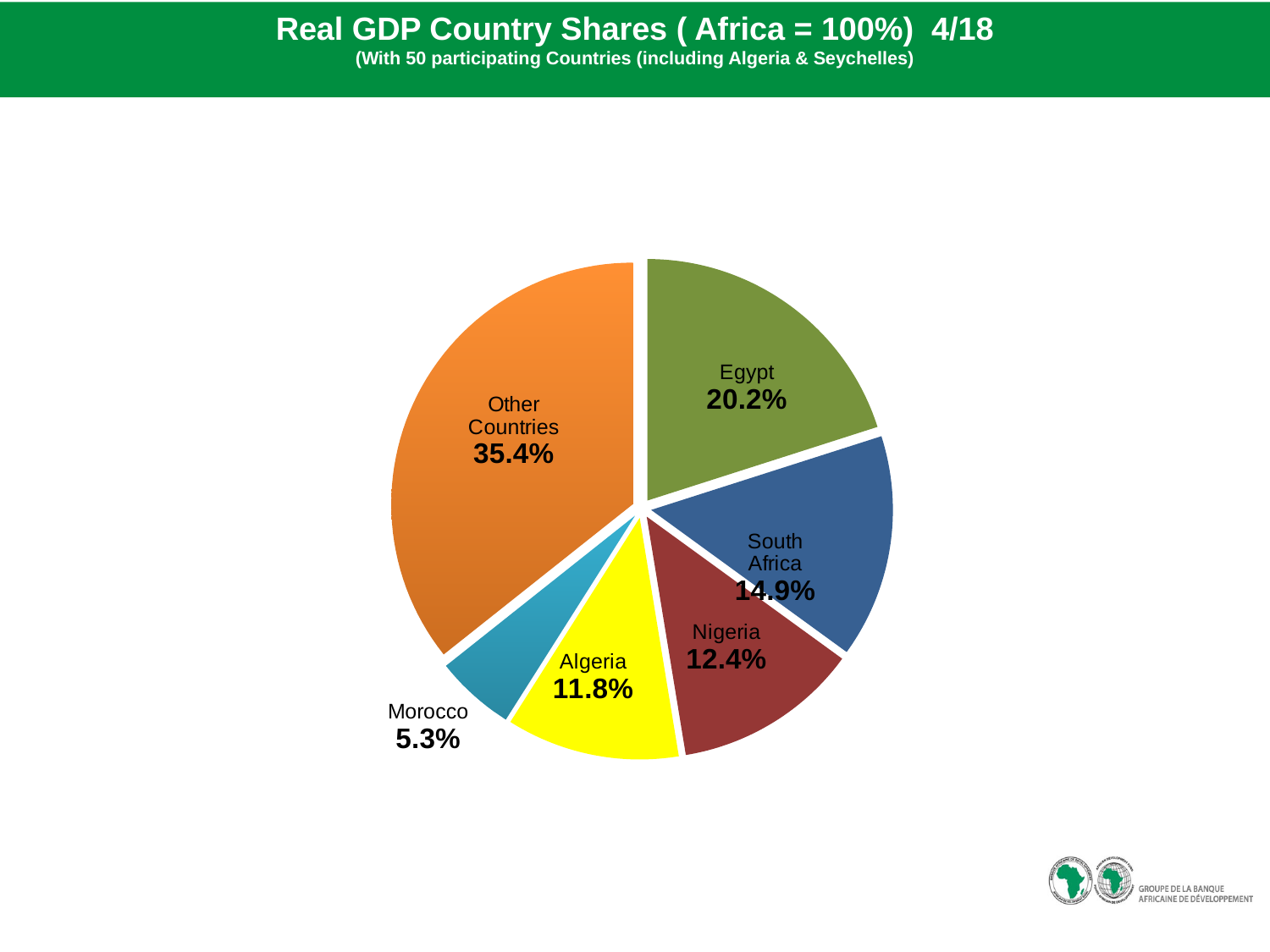
What is the difference in share between Egypt and South Africa? 5.3% What share of real GDP does Algeria hold? 11.8% What share of real GDP does Nigeria hold? 12.4% What share of real GDP does Morocco hold? 5.3% Which has a larger share, Nigeria or Algeria? Nigeria Which slice of the pie chart is the largest? Other Countries What kind of chart is shown on the slide? Pie chart What share of real GDP does Egypt hold in the pie chart? 20.2% Which named slice of the pie chart is the smallest? Morocco What colour is the Algeria slice? Yellow What share of real GDP does South Africa hold? 14.9% How many slices does the pie chart have? 6